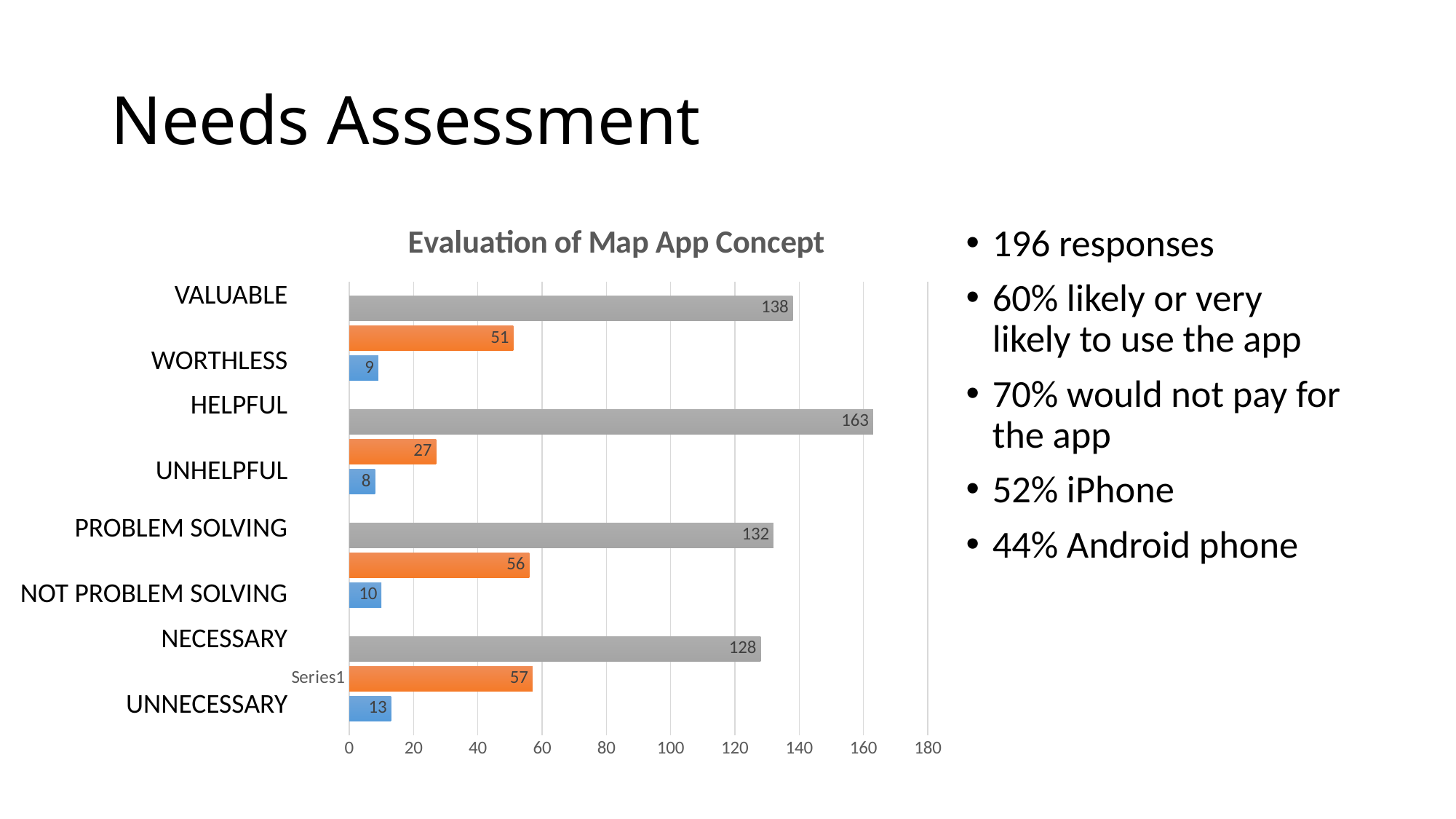
Is the value of the gray bar next to the PROBLEM SOLVING label greater or less than 120? greater What is the smallest value shown on any bar in the chart? 8 What is the value of the topmost gray bar, next to the VALUABLE label? 138 What is the title of the chart on the slide? Evaluation of Map App Concept Which is larger: the orange bar in the bottom group (57) or the orange bar in the top group (51)? 57 What is the highest value shown on the horizontal axis of the chart? 180 What is the value of the longest gray bar in the chart? 163 What kind of chart is shown under the title "Evaluation of Map App Concept"? bar chart What is the difference between the longest gray bar (163) and the topmost gray bar (138)? 25 How many bars are plotted in the chart in total? 12 What is the value of the blue bar at the bottom of the chart, next to the UNNECESSARY label? 13 What is the value of the orange bar in the second group from the top, between HELPFUL and UNHELPFUL? 27